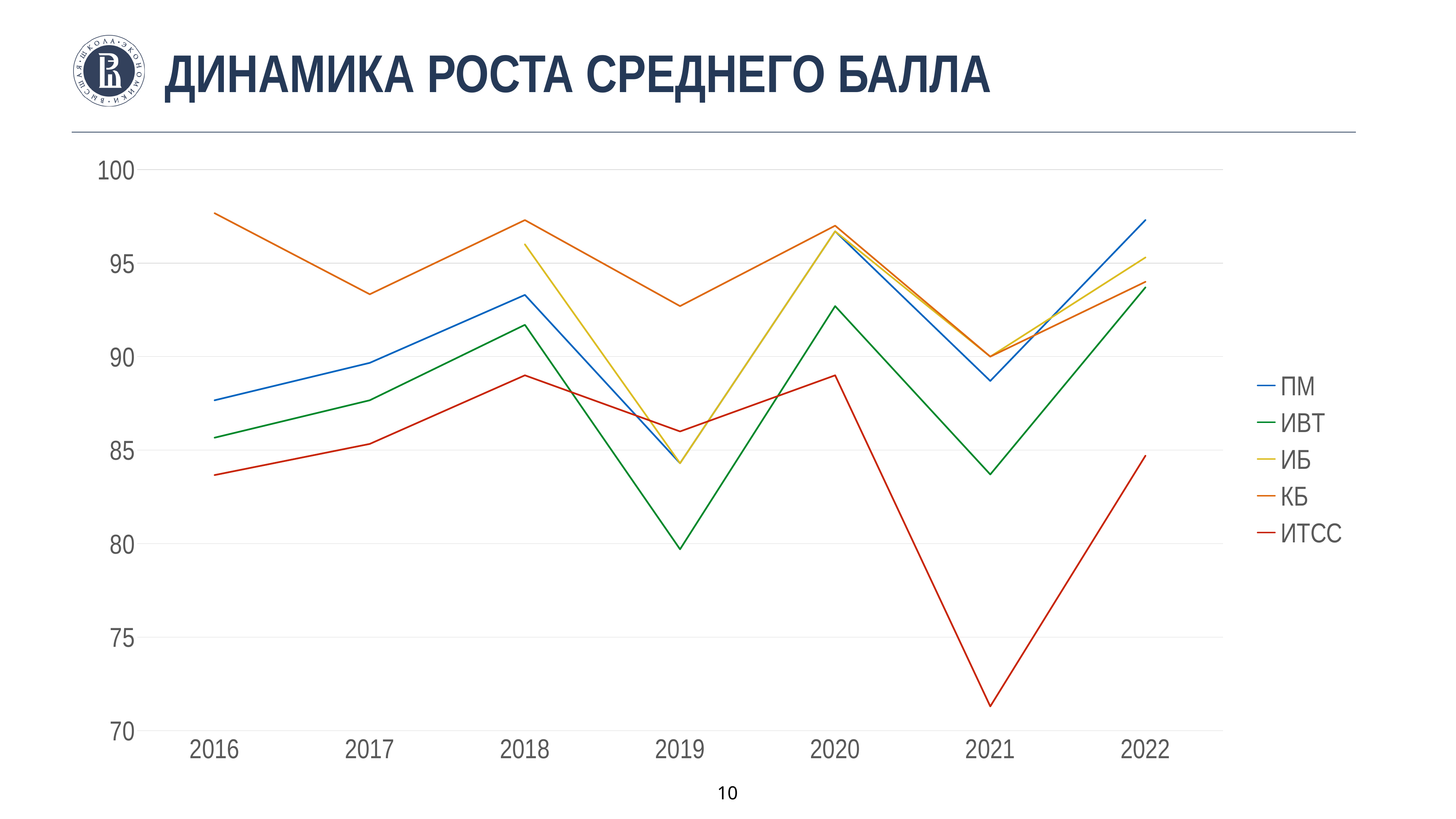
Does the ИВТ line rise or fall from 2016 to 2018? rises What is the title of the chart? ДИНАМИКА РОСТА СРЕДНЕГО БАЛЛА How many years are shown on the x axis? 7 Is the value for ПМ in 2022 greater or less than 95? greater What kind of chart is shown on the slide? line chart Which series has the lowest value in 2016? ИТСС How many series does the legend list? 5 Is the value for ИТСС in 2021 greater or less than 75? less In 2019, which is higher: ИВТ or ИТСС? ИТСС Which series has the highest value in 2016? КБ Which series has the lowest value in 2021? ИТСС Is the value for КБ in 2017 greater or less than 90? greater